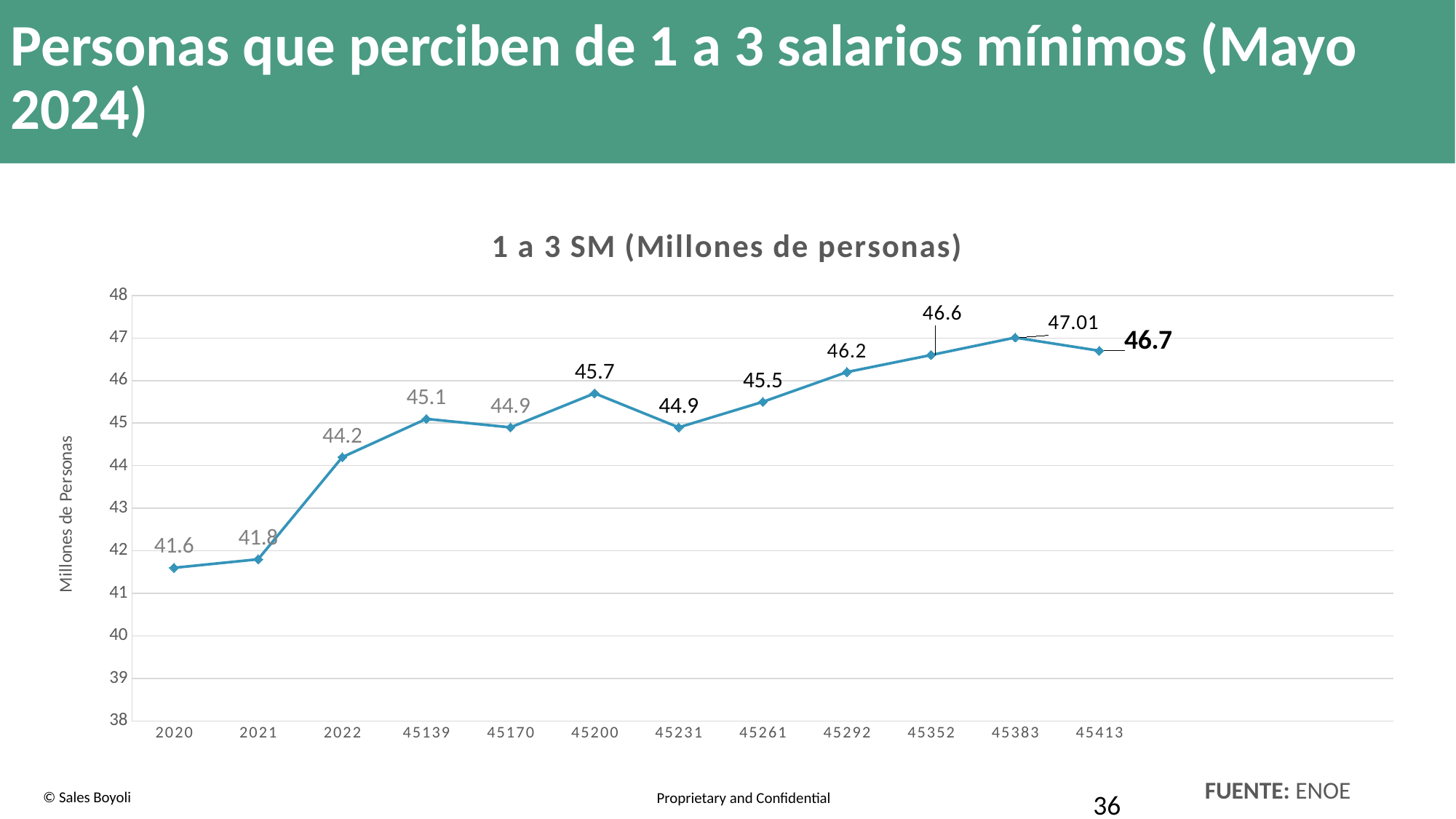
Do the values generally rise or fall from 2020 to 45383? rise What is the value for 45383? 47.01 Which category has the lowest value? 2020 What is the difference between the values for 2022 and 2021? 2.4 How many data points are plotted on the chart? 12 What is the value for 2020? 41.6 What is the value for 45413? 46.7 What is the title of the chart? 1 a 3 SM (Millones de personas) What type of chart is shown on the slide? line chart Which is larger, the value for 45200 or the value for 45231? 45200 What is the value for 2022? 44.2 Which category has the highest value? 45383